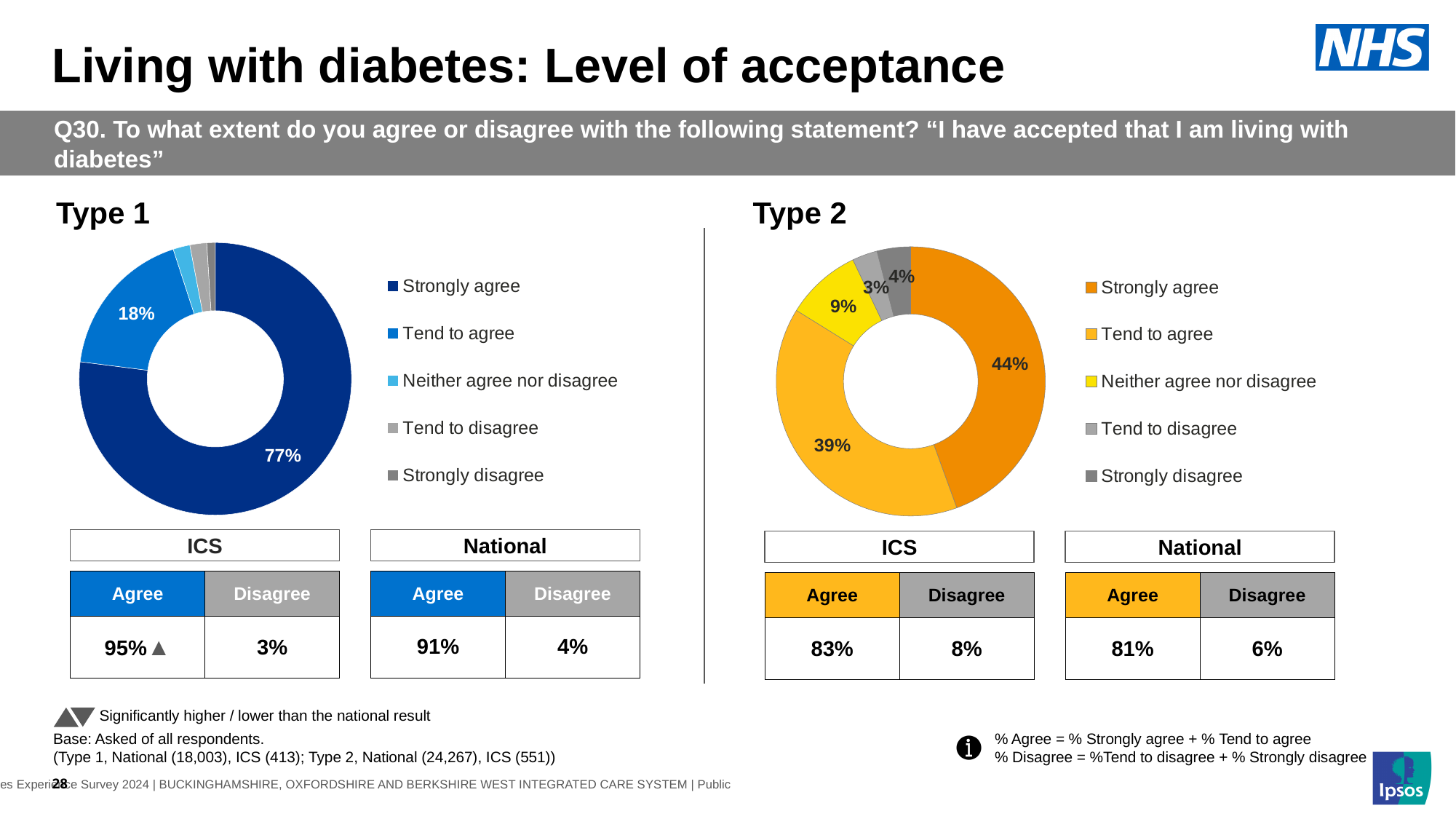
In the Type 1 chart, what percentage of respondents tend to agree? 18% In the Type 1 chart, what percentage of respondents strongly agree? 77% How many categories does the legend of the Type 2 chart list? 5 In the Type 2 chart, what percentage of respondents neither agree nor disagree? 9% In the Type 2 chart, what percentage of respondents tend to agree? 39% In the Type 1 chart, which response category has the largest share? Strongly agree What kind of chart is used for Type 1? Donut (pie) chart In the Type 2 chart, what percentage of respondents strongly disagree? 4% In the Type 2 chart, which response category has the largest share? Strongly agree In the Type 2 chart, what percentage of respondents strongly agree? 44% In the Type 2 chart, what is the difference between the Strongly agree and Tend to agree shares? 5 percentage points In the Type 1 chart, which is larger: the Strongly agree share or the Tend to agree share? Strongly agree